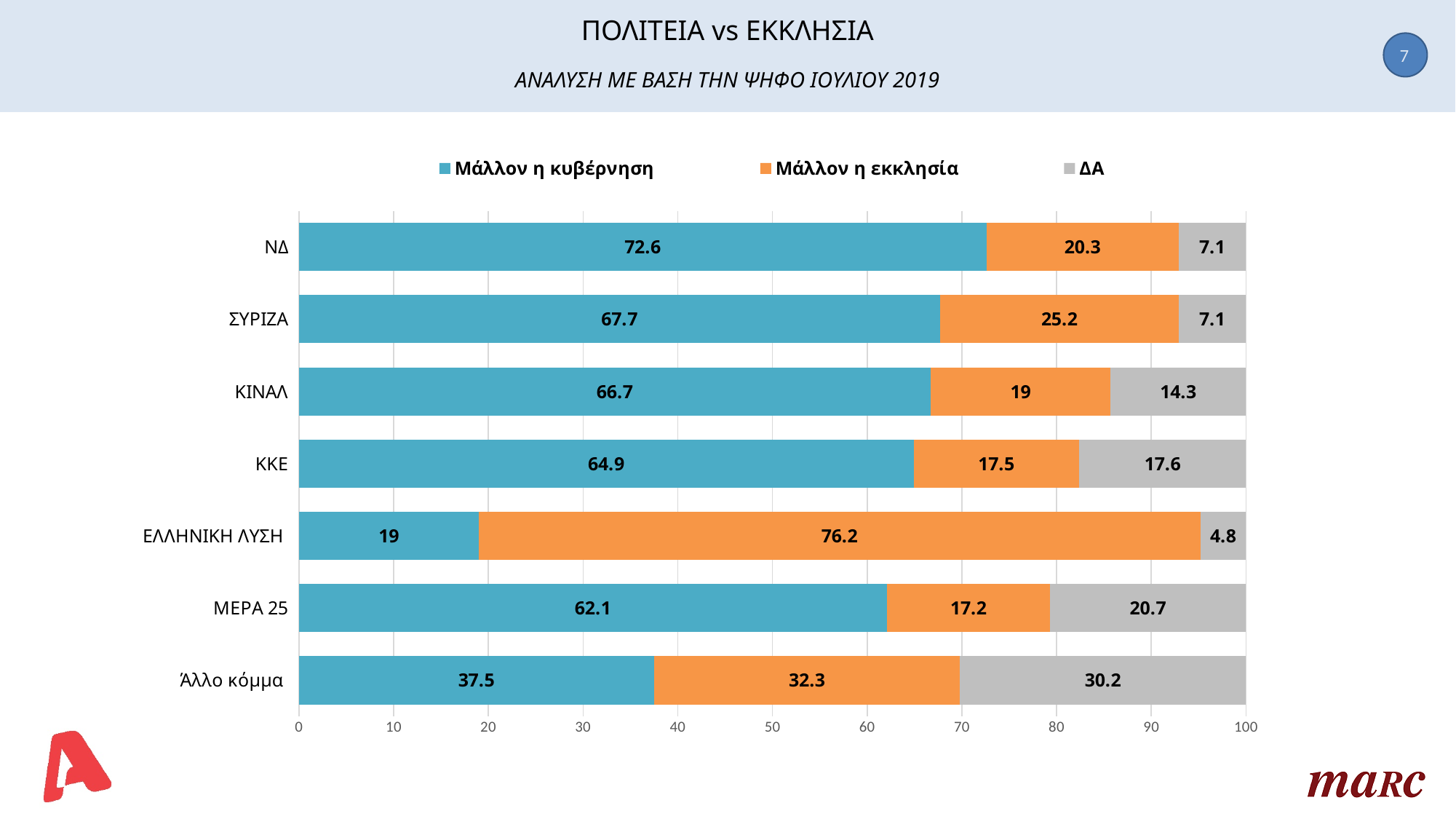
Which category has the highest value for 'Μάλλον η εκκλησία'? ΕΛΛΗΝΙΚΗ ΛΥΣΗ Which category has the lowest value for 'Μάλλον η κυβέρνηση'? ΕΛΛΗΝΙΚΗ ΛΥΣΗ For ΚΙΝΑΛ, which is larger: 'Μάλλον η εκκλησία' or 'ΔΑ'? Μάλλον η εκκλησία What is the 'ΔΑ' value for ΜΕΡΑ 25? 20.7 What is the total of the stacked bar for Άλλο κόμμα? 100 What kind of chart is shown on the slide? Stacked bar chart What is the value of 'Μάλλον η κυβέρνηση' for ΝΔ? 72.6 Which category has the highest 'ΔΑ' value? Άλλο κόμμα How many series does the legend list? 3 What is the value of 'Μάλλον η εκκλησία' for ΣΥΡΙΖΑ? 25.2 How many party categories are plotted on the chart? 7 What is the difference between the 'Μάλλον η κυβέρνηση' values for ΝΔ and ΣΥΡΙΖΑ? 4.9